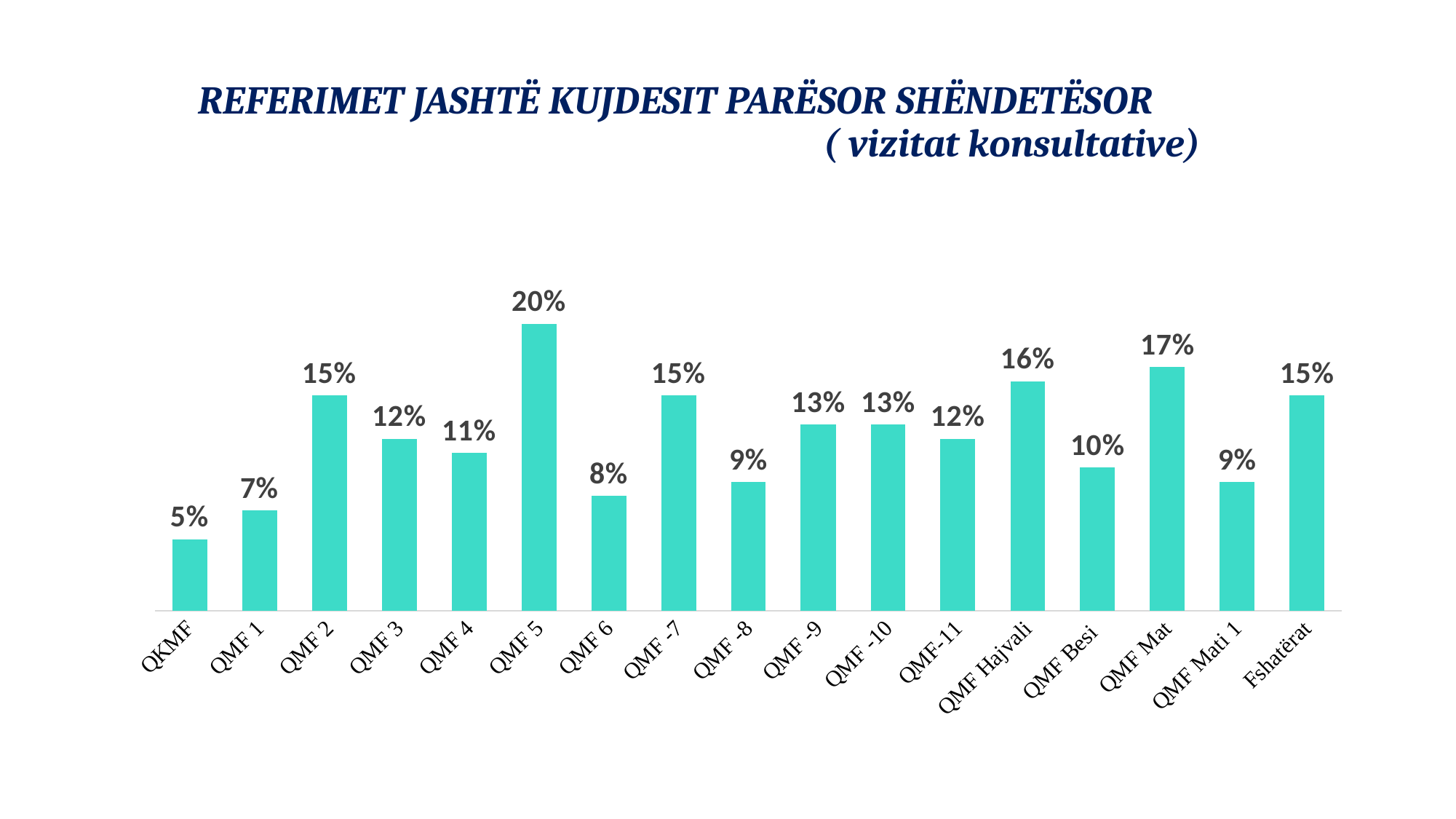
Which is larger, the value for QMF 2 or the value for QMF 6? QMF 2 How many categories are shown on the x axis? 17 What kind of chart is shown on the slide? Bar chart Which category has the lowest value? QKMF What is the difference between the values for QMF 5 and QKMF? 15% What is the title of the chart? REFERIMET JASHTË KUJDESIT PARËSOR SHËNDETËSOR ( vizitat konsultative) What is the value for QKMF? 5% What is the difference between the values for QMF Mat and QMF Besi? 7% What is the value for QMF 5? 20% What is the value for Fshatërat? 15% What is the value for QMF Hajvali? 16% Which category has the highest value? QMF 5